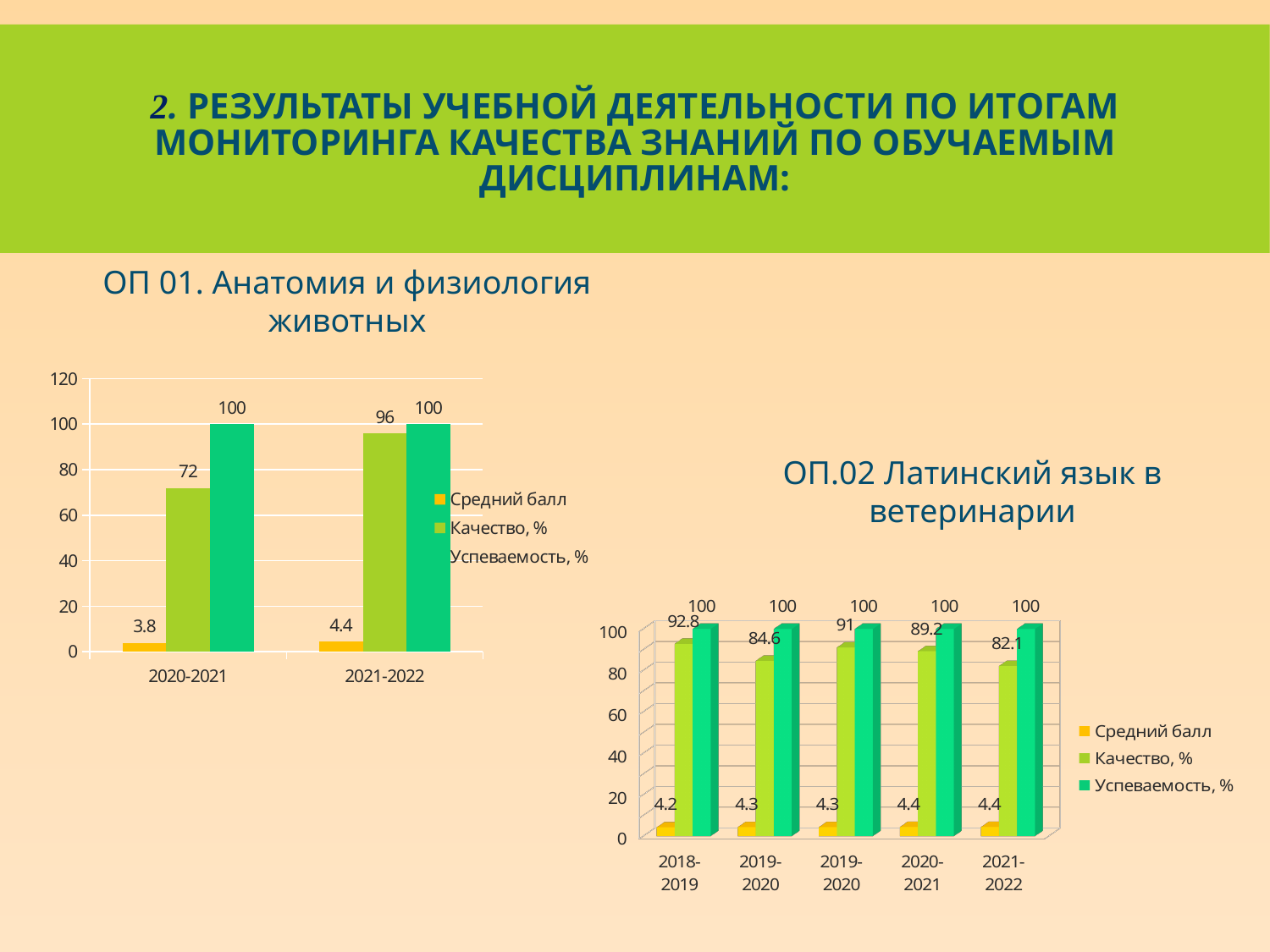
In the chart 'ОП 01. Анатомия и физиология животных', how many series does the legend list? 3 In the chart 'ОП.02 Латинский язык в ветеринарии', which category has the highest 'Качество, %'? 2018-2019 What kind of chart is 'ОП.02 Латинский язык в ветеринарии'? bar chart In the chart 'ОП.02 Латинский язык в ветеринарии', what is the value of 'Качество, %' for 2021-2022? 82.1 In the chart 'ОП.02 Латинский язык в ветеринарии', what is the value of 'Качество, %' for 2018-2019? 92.8 In the chart 'ОП 01. Анатомия и физиология животных', how many categories are shown on the x axis? 2 In the chart 'ОП 01. Анатомия и физиология животных', what is the value of 'Качество, %' for 2020-2021? 72 In the chart 'ОП.02 Латинский язык в ветеринарии', what is the value of 'Успеваемость, %' for 2020-2021? 100 In the chart 'ОП 01. Анатомия и физиология животных', what is the value of 'Средний балл' for 2021-2022? 4.4 In the chart 'ОП 01. Анатомия и физиология животных', does 'Качество, %' rise or fall from 2020-2021 to 2021-2022? rise In the chart 'ОП.02 Латинский язык в ветеринарии', which category has the lowest 'Качество, %'? 2021-2022 In the chart 'ОП 01. Анатомия и физиология животных', what is the difference in 'Качество, %' between 2021-2022 and 2020-2021? 24